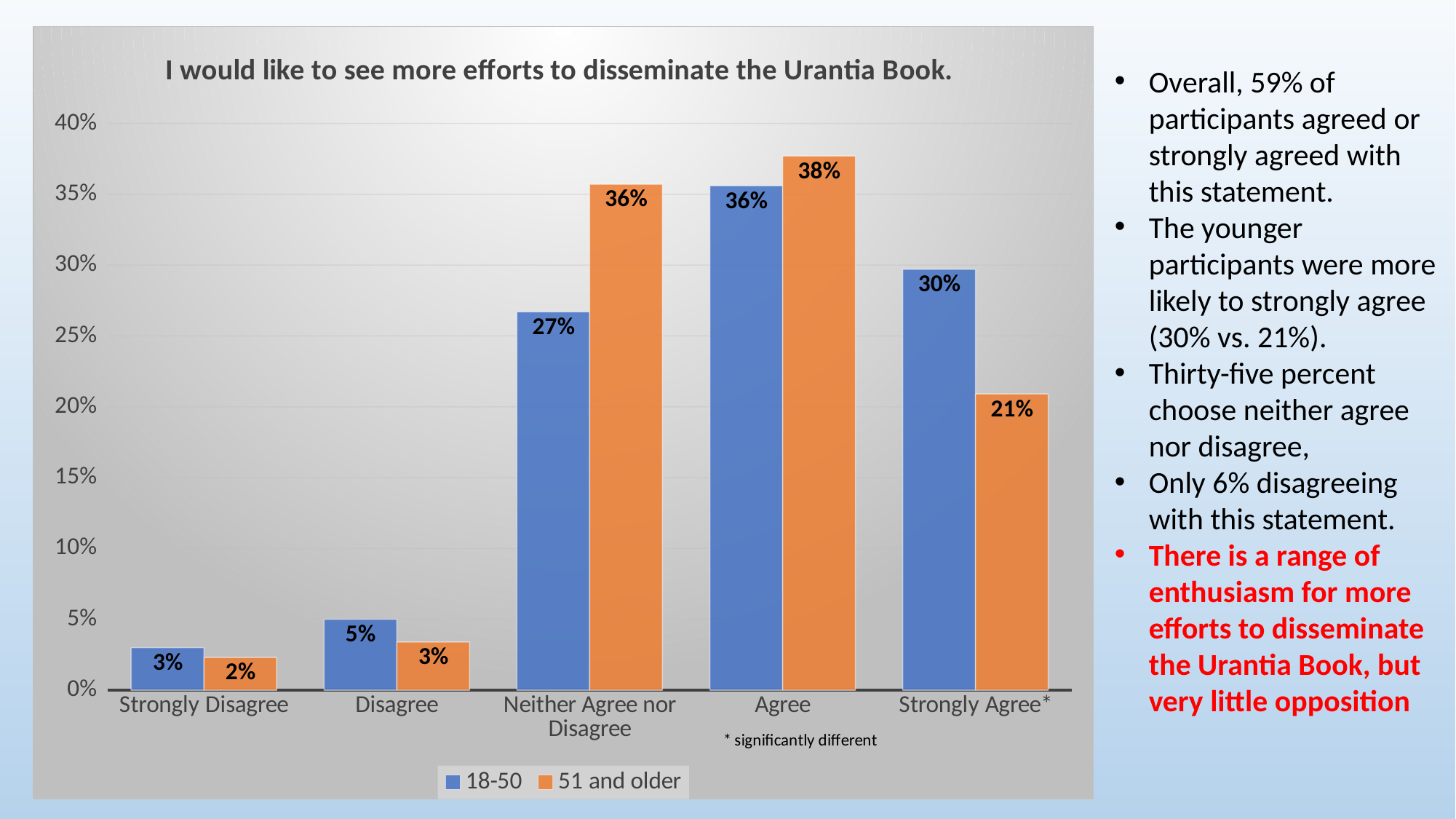
What is the difference between the 18-50 and 51 and older values in the Strongly Agree* category? 9% Is the value for the 51 and older series in the Agree category greater or less than 35%? greater What is the title of the chart? I would like to see more efforts to disseminate the Urantia Book. Which category has the lowest value for the 51 and older series? Strongly Disagree What is the value for the 18-50 series in the Neither Agree nor Disagree category? 27% What is the value for the 51 and older series in the Agree category? 38% What kind of chart is shown on the slide? bar chart How many categories are shown on the x axis? 5 In the Neither Agree nor Disagree category, which series has the larger value, 18-50 or 51 and older? 51 and older What is the value for the 18-50 series in the Strongly Agree* category? 30% How many series does the legend list? 2 Which category has the highest value for the 51 and older series? Agree